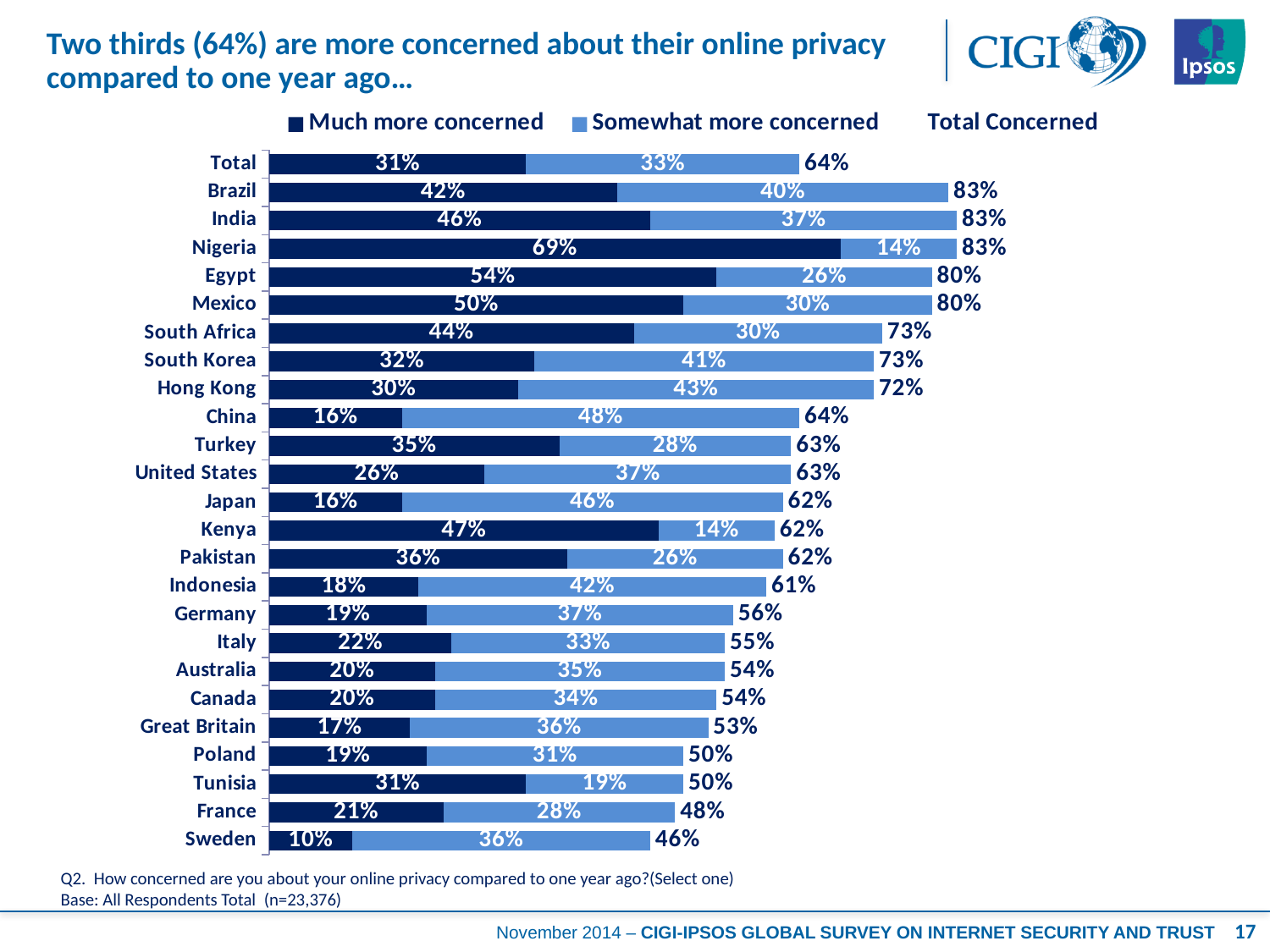
What is the Total Concerned value for Brazil, combining "Much more concerned" and "Somewhat more concerned"? 83% Which colour represents "Much more concerned" in the chart? Dark blue What is the Total Concerned value for Sweden? 46% What kind of chart is shown on the slide? Stacked bar chart Which has a larger "Somewhat more concerned" value, Hong Kong or Kenya? Hong Kong Which country has the highest "Much more concerned" percentage? Nigeria How many countries (excluding the Total row) are shown in the chart? 24 What is the difference between the "Much more concerned" values for Egypt and Mexico? 4% What percentage of respondents in Nigeria are "Much more concerned" about their online privacy? 69% Which country has the lowest "Much more concerned" percentage? Sweden What is the "Somewhat more concerned" value for China? 48% How many series does the legend list? 3